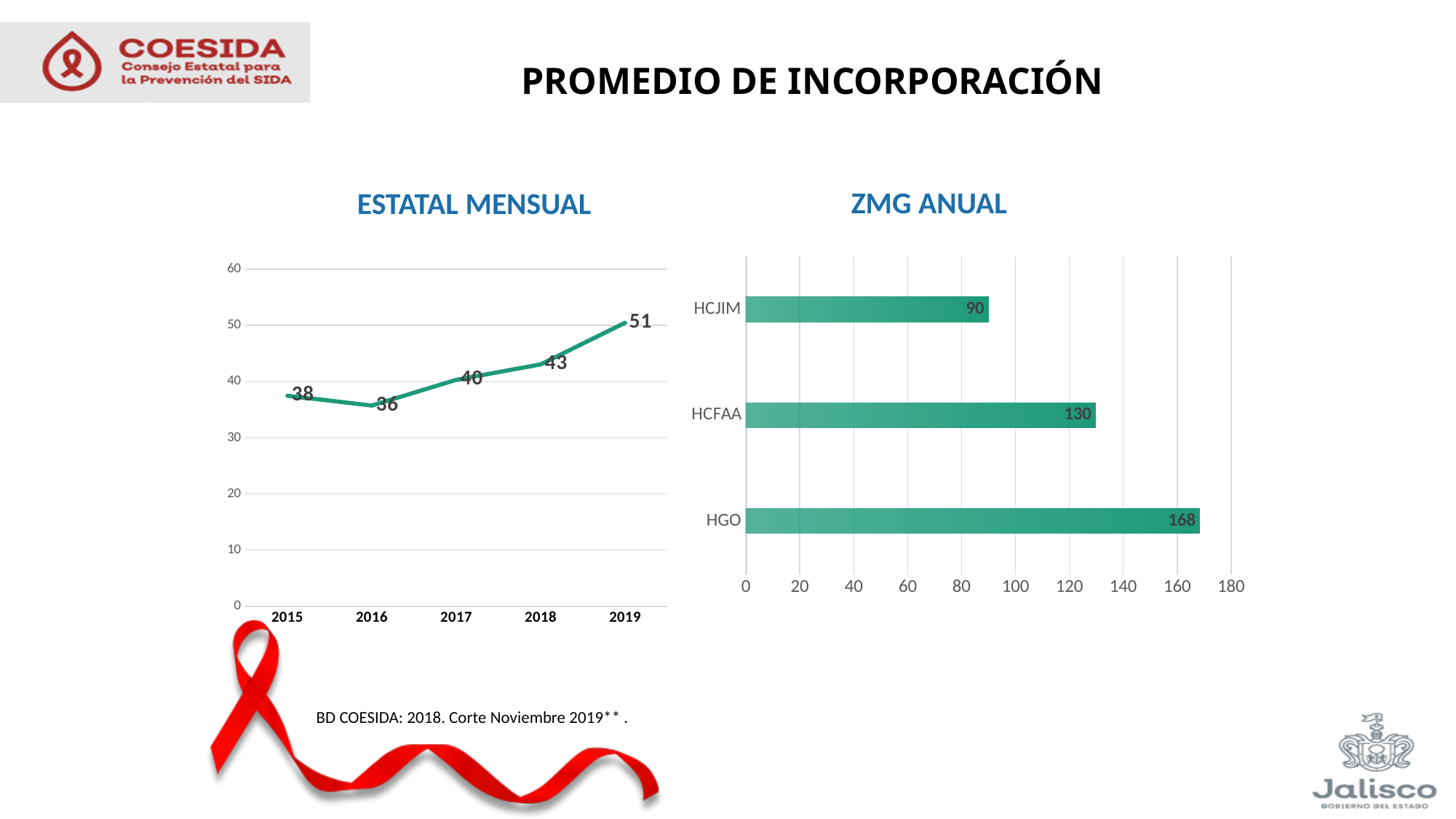
In the ESTATAL MENSUAL chart, how many years are plotted? 5 In the ZMG ANUAL chart, is the value for HCJIM greater or less than 100? less In the ESTATAL MENSUAL chart, what is the difference between the values for 2019 and 2015? 13 In the ZMG ANUAL chart, what is the difference between the values for HGO and HCJIM? 78 What kind of chart is the ZMG ANUAL chart? bar chart What kind of chart is the ESTATAL MENSUAL chart? line chart In the ESTATAL MENSUAL chart, which year has the lowest value? 2016 In the ESTATAL MENSUAL chart, which year has the highest value? 2019 In the ESTATAL MENSUAL chart, what is the value for 2017? 40 In the ZMG ANUAL chart, which category has the highest value? HGO In the ZMG ANUAL chart, what is the value for HCFAA? 130 In the ESTATAL MENSUAL chart, do the values rise or fall from 2016 to 2019? rise